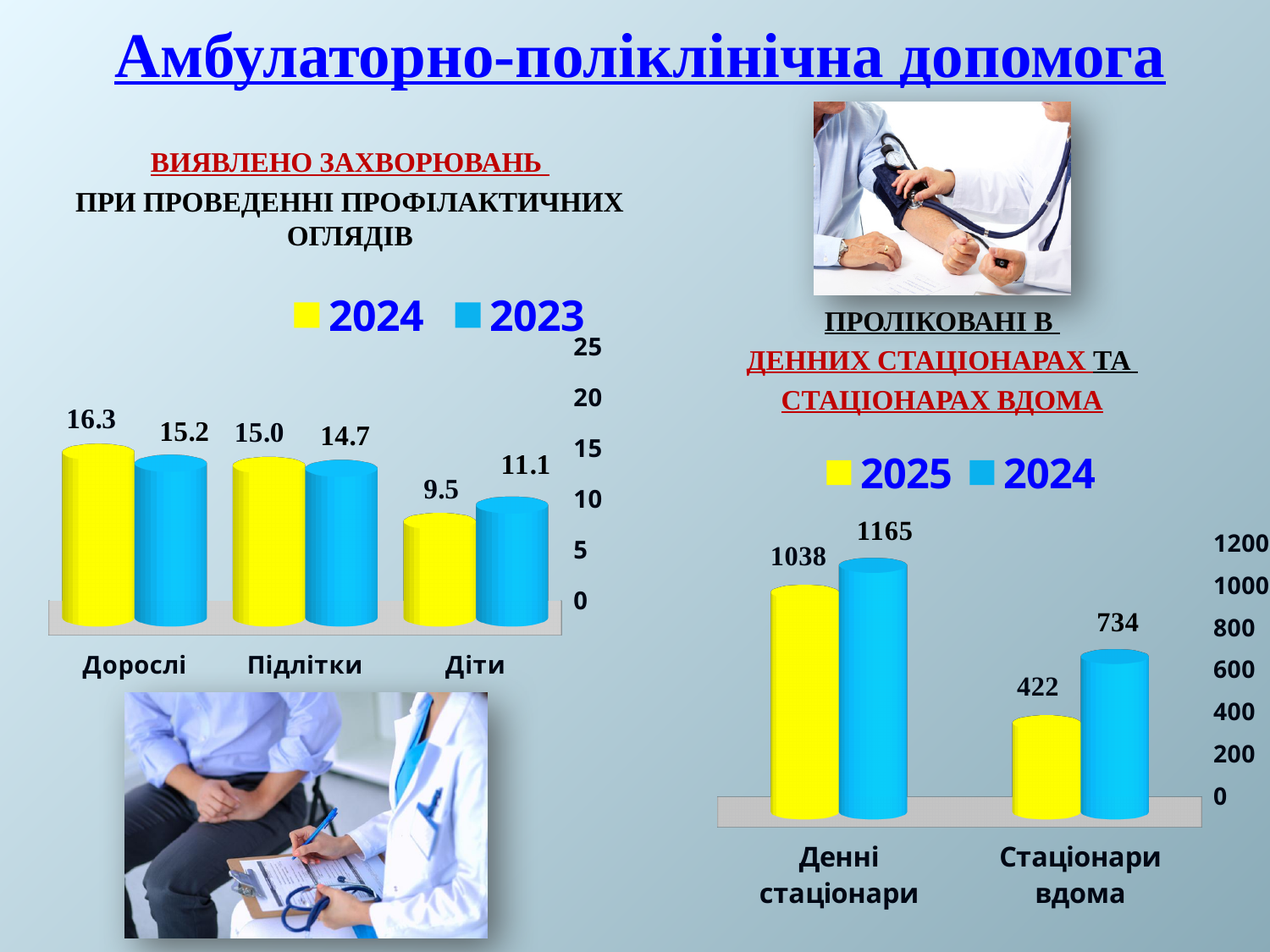
In the left chart, which category has the lowest 2024 value? Діти In the right chart, which colour represents the 2025 series? Yellow In the right chart, what is the 2025 value for Стаціонари вдома? 422 In the left chart, what is the 2023 value for Діти? 11.1 In the left chart, what is the 2024 value for Дорослі? 16.3 In the left chart, what is the difference between the 2024 and 2023 values for Дорослі? 1.1 What kind of chart is the right chart? Bar chart In the left chart, how many series does the legend list? 2 In the right chart, what is the difference between the 2024 and 2025 values for Стаціонари вдома? 312 In the right chart, what is the 2024 value for Денні стаціонари? 1165 In the left chart, how many categories are shown on the x axis? 3 In the left chart, for Діти, which year has the larger value, 2024 or 2023? 2023